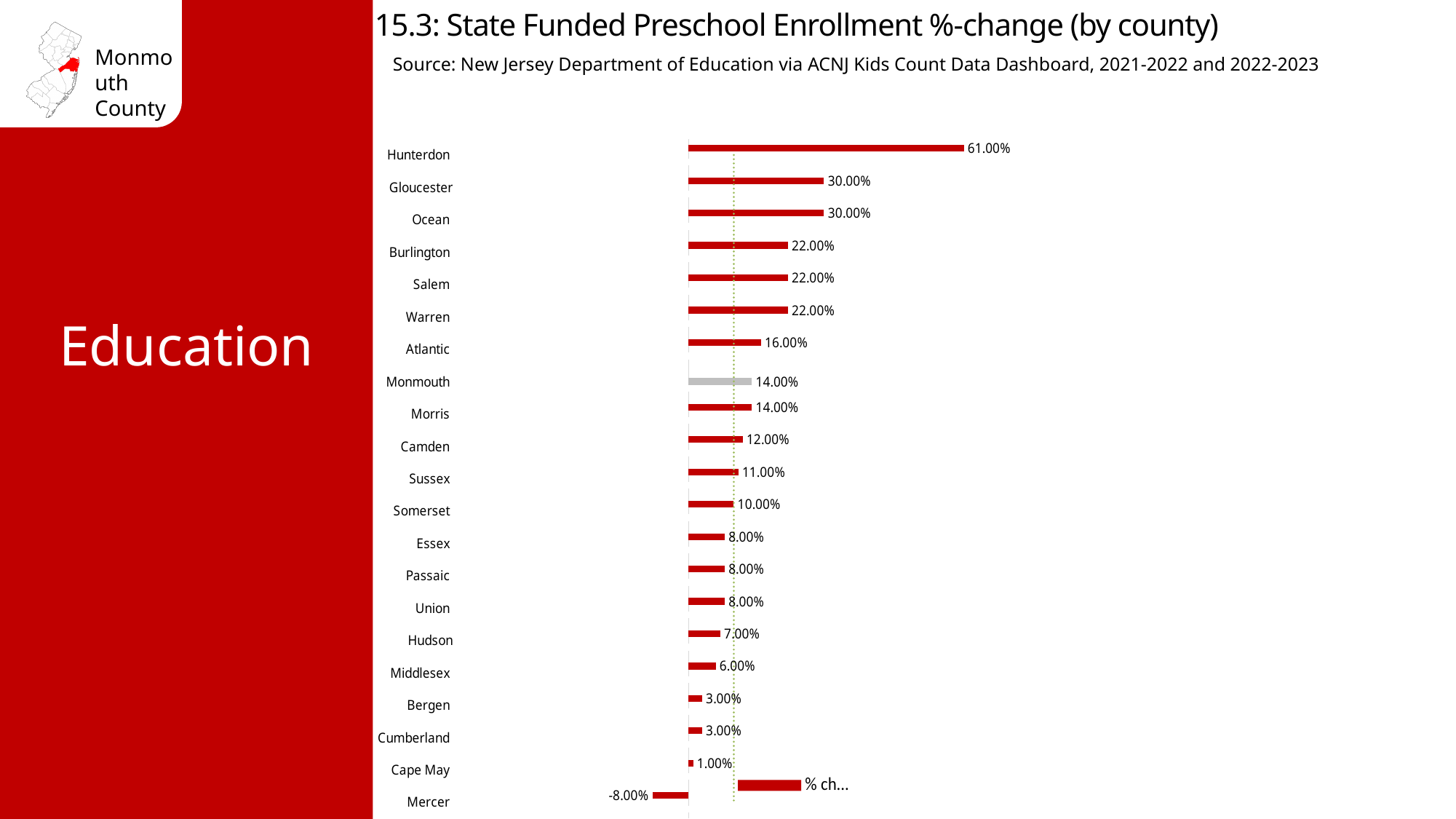
Which is larger, the value for Atlantic or the value for Monmouth? Atlantic What is the state funded preschool enrollment %-change for Monmouth? 14.00% What is the difference between the values for Hunterdon and Monmouth? 47.00% Which is larger, the value for Camden or the value for Somerset? Camden What is the difference between the values for Gloucester and Atlantic? 14.00% Which county has the lowest %-change? Mercer What kind of chart is shown on the slide? Bar chart How many counties are shown in the chart? 21 What is the value shown for Hunterdon? 61.00% Which county has the highest %-change? Hunterdon Which county's bar is coloured grey instead of red? Monmouth What is the value shown for Mercer? -8.00%